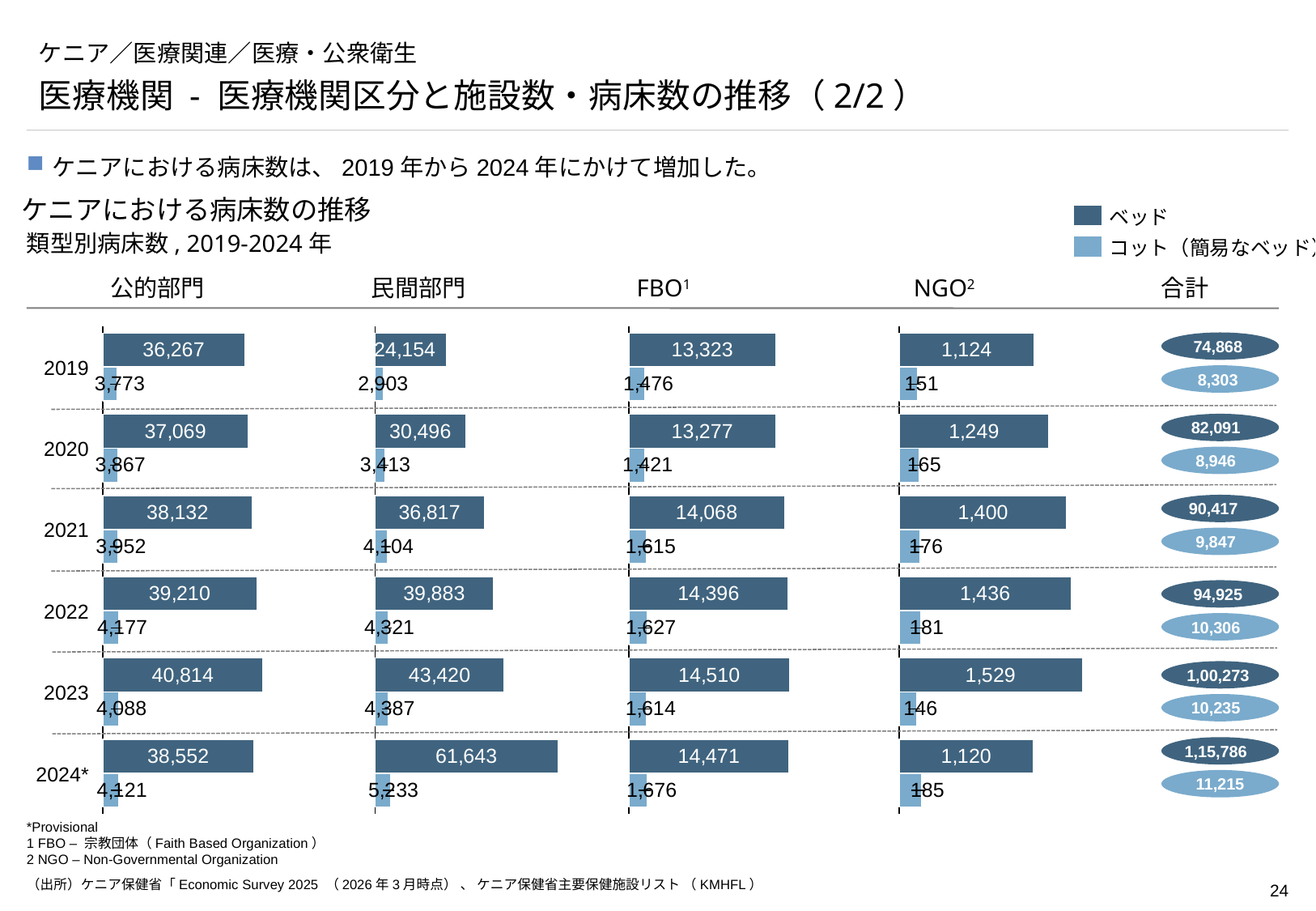
How many years are shown in the chart? 6 What is the 合計 value for ベッド in 2024*, as printed on the slide? 1,15,786 What is the 合計 value for コット in 2022? 10,306 What is the number of コット in the FBO column for 2021? 1,615 In 2022, which has more ベッド: 公的部門 or 民間部門? 民間部門 How many series does the legend list? 2 What is the number of ベッド (beds) in the 公的部門 column for 2019? 36,267 What is the difference between the 公的部門 ベッド values for 2023 and 2022? 1,604 In which year is the number of コット in the NGO column the lowest? 2023 What is the number of ベッド in the 民間部門 column for 2024*? 61,643 In which year is the number of ベッド in the 民間部門 column the highest? 2024* Does the 合計 number of ベッド rise or fall from 2019 to 2024*? rise